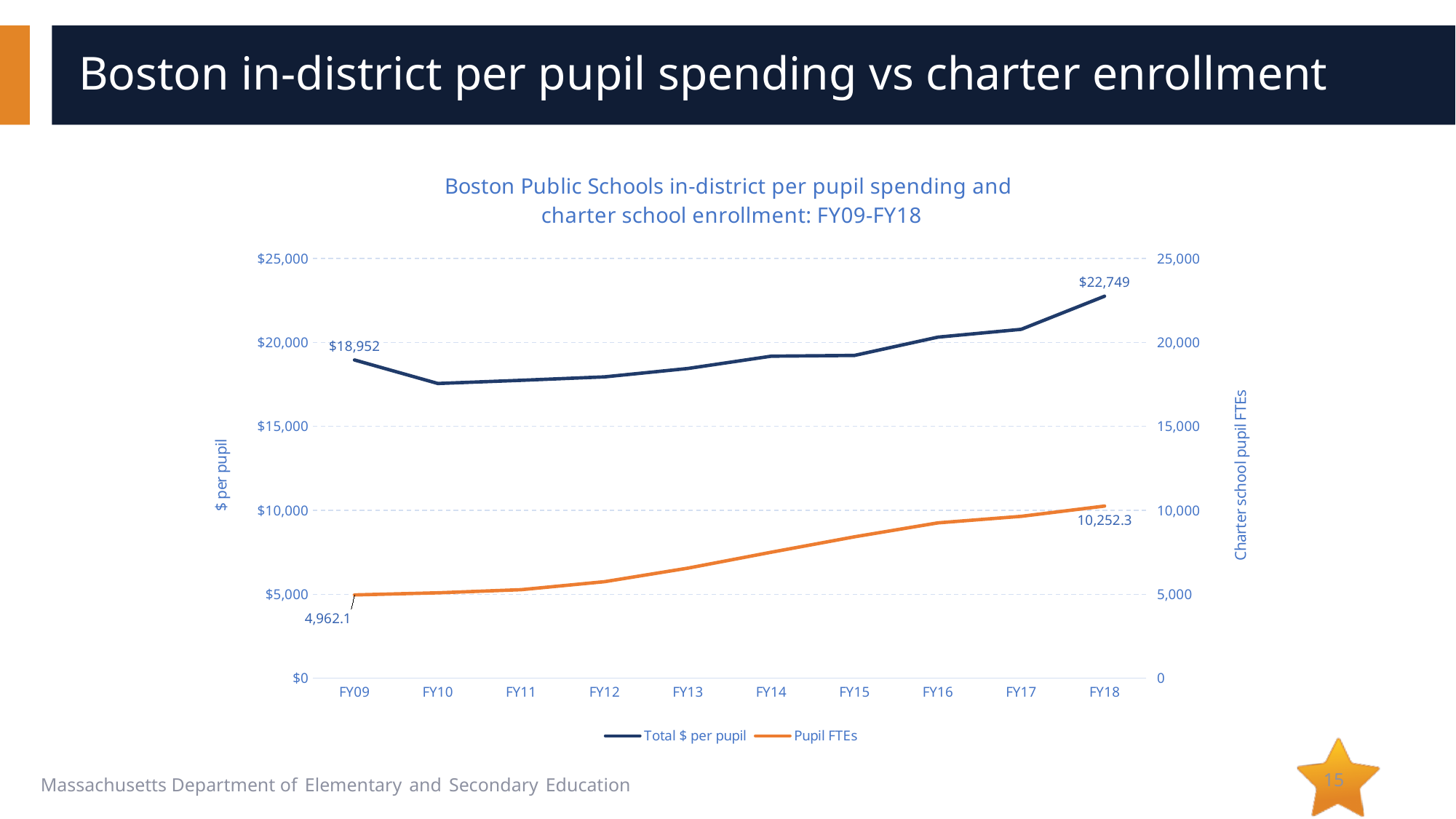
What kind of chart is shown on the slide? Line chart Is the Total $ per pupil value for FY10 greater or less than $20,000? less By how much did Total $ per pupil increase from FY09 to FY18? $3,797 How many fiscal years are plotted on the x axis? 10 What is the Pupil FTEs value for FY18? 10,252.3 What is the Total $ per pupil value for FY09? $18,952 Is the Pupil FTEs value for FY14 greater or less than 5,000? greater What is the difference in Pupil FTEs between FY18 and FY09? 5,290.2 What is the Total $ per pupil value for FY18? $22,749 In which fiscal year is Total $ per pupil highest? FY18 What is the Pupil FTEs value for FY09? 4,962.1 How many series does the legend list? 2